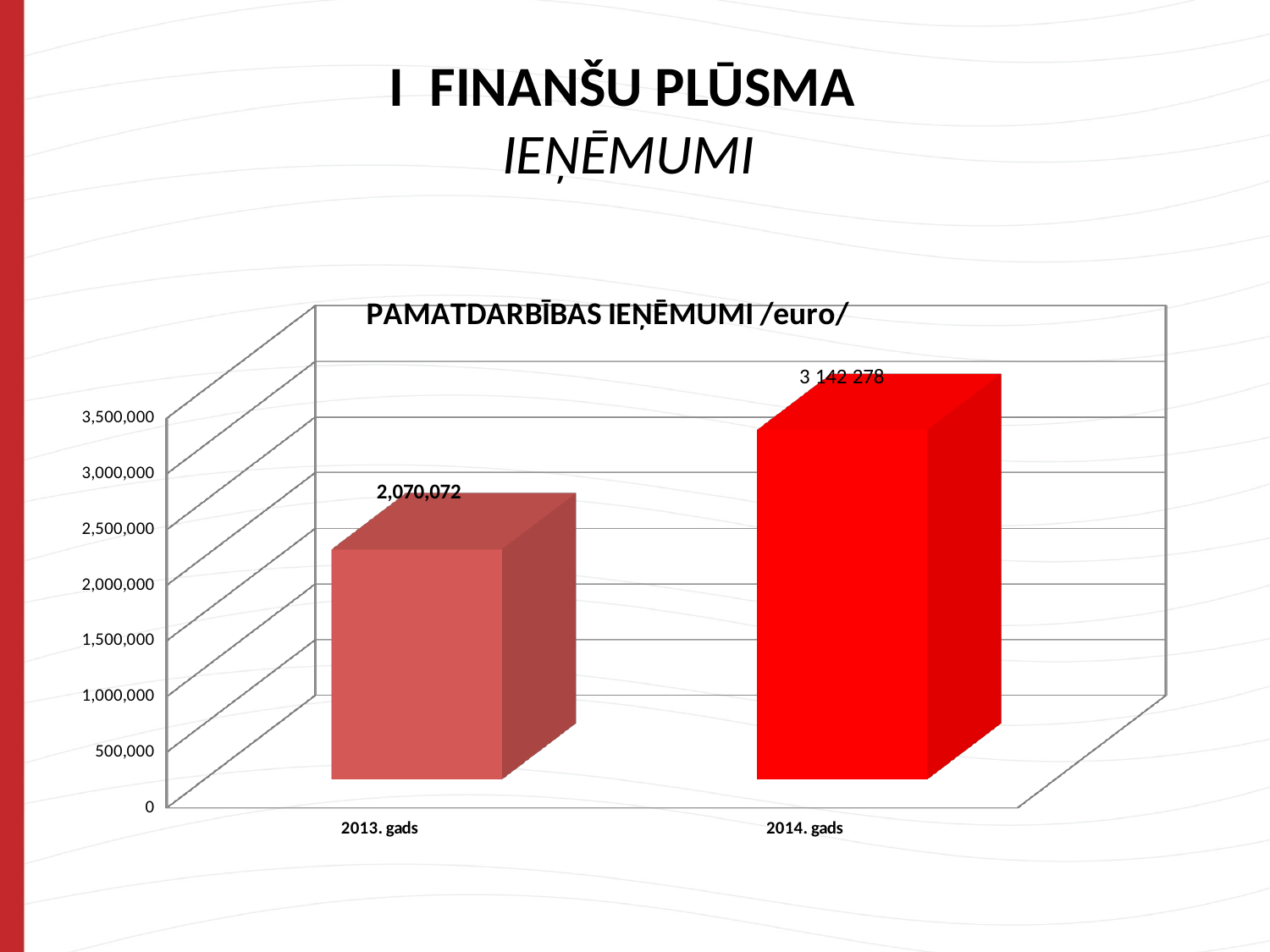
What is the value for 2013. gads? 2,070,072 What is the difference between the values for 2014. gads and 2013. gads? 1,072,206 Is the value for 2014. gads greater or less than 3,000,000? greater Which year has the highest value? 2014. gads Which is larger, the value for 2013. gads or the value for 2014. gads? 2014. gads Do the values rise or fall from 2013. gads to 2014. gads? rise Is the value for 2013. gads greater or less than 2,500,000? less How many categories are shown on the x axis? 2 What is the value for 2014. gads? 3 142 278 What kind of chart is shown on the slide? bar chart Which year has the lowest value? 2013. gads What is the title of the chart? PAMATDARBĪBAS IEŅĒMUMI /euro/